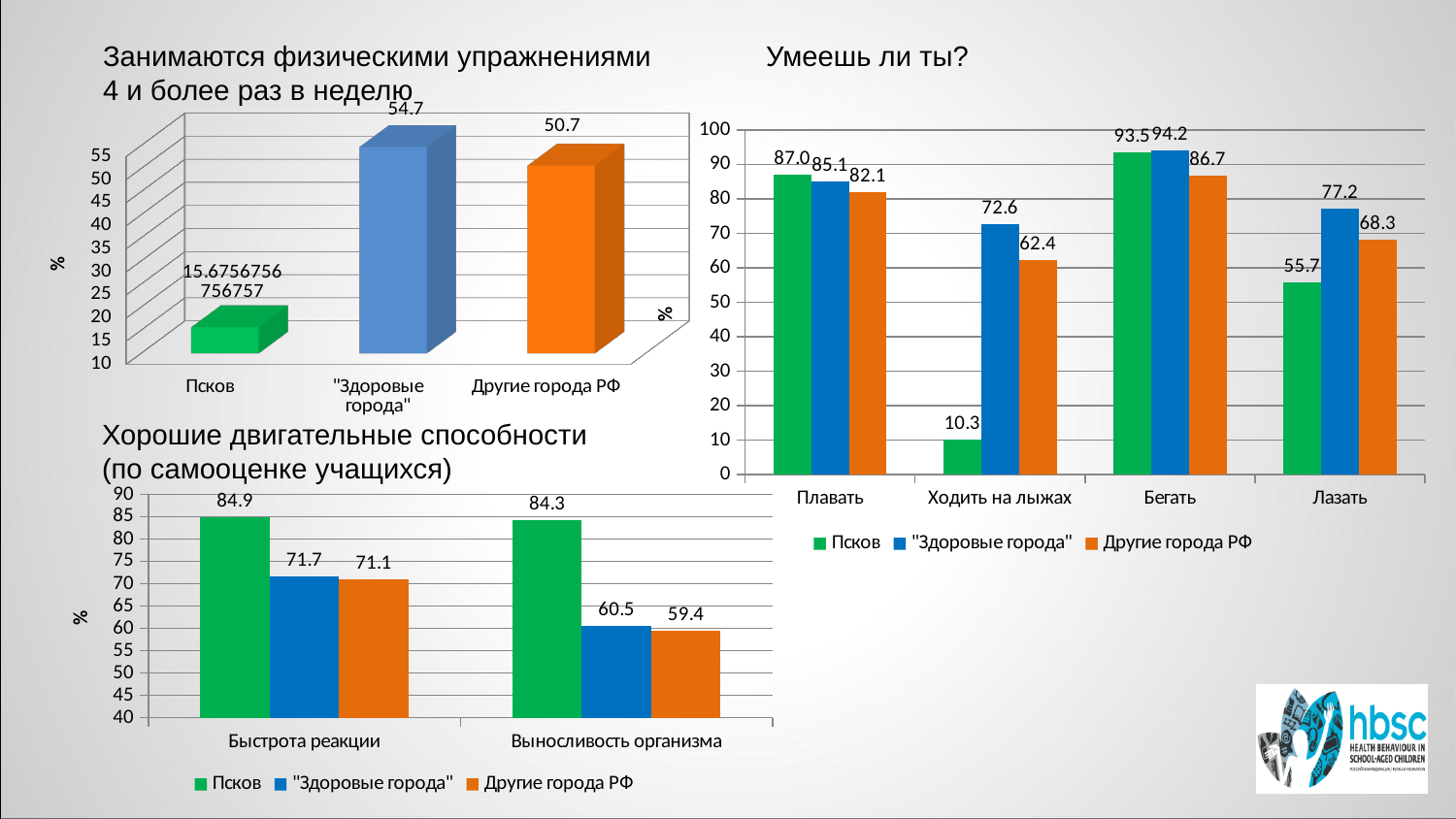
In the chart 'Занимаются физическими упражнениями 4 и более раз в неделю', is the value for Псков greater or less than 20? less In the chart 'Хорошие двигательные способности (по самооценке учащихся)', what is the value for Псков in the category Выносливость организма? 84.3 In the chart 'Занимаются физическими упражнениями 4 и более раз в неделю', what is the value for "Здоровые города"? 54.7 In the chart 'Умеешь ли ты?', which category has the highest value for Другие города РФ? Бегать In the chart 'Умеешь ли ты?', what is the value for Псков in the category Ходить на лыжах? 10.3 In the chart 'Занимаются физическими упражнениями 4 и более раз в неделю', which category has the lowest value? Псков In the chart 'Умеешь ли ты?', how many categories are shown on the x axis? 4 In the chart 'Умеешь ли ты?', what is the value for "Здоровые города" in the category Лазать? 77.2 In the chart 'Умеешь ли ты?', how many series does the legend list? 3 In the chart 'Хорошие двигательные способности (по самооценке учащихся)', what is the difference between the Псков and "Здоровые города" values for Быстрота реакции? 13.2 What type of chart is 'Хорошие двигательные способности (по самооценке учащихся)'? bar chart In the chart 'Умеешь ли ты?', what is the difference between the "Здоровые города" and Другие города РФ values for Ходить на лыжах? 10.2